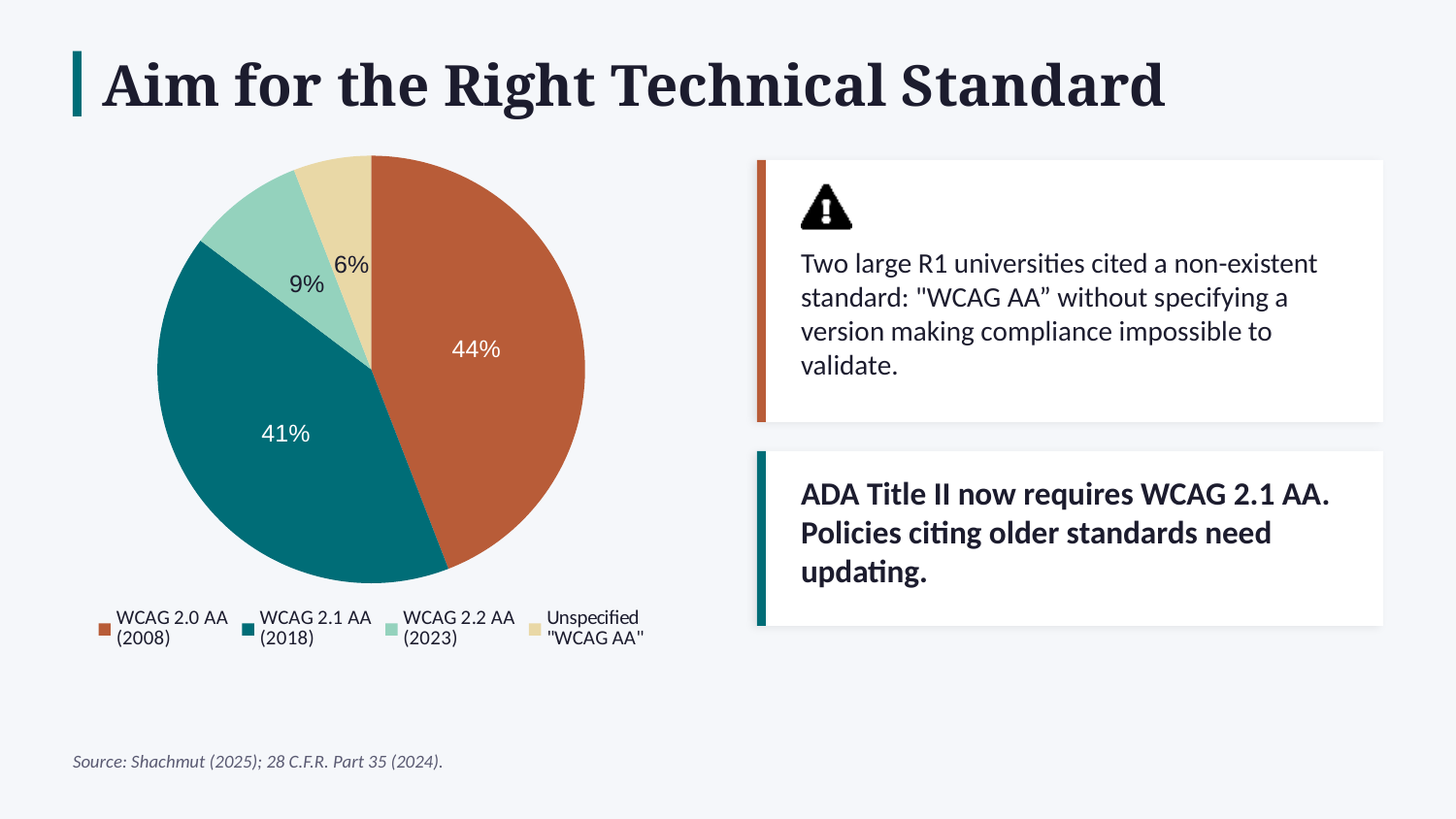
What is the combined share of WCAG 2.2 AA (2023) and Unspecified "WCAG AA"? 15% Which category has the smallest slice of the pie? Unspecified "WCAG AA" What share of the pie is WCAG 2.0 AA (2008)? 44% What kind of chart is shown on the slide? Pie chart Which is larger: the WCAG 2.2 AA (2023) slice or the Unspecified "WCAG AA" slice? WCAG 2.2 AA (2023) How many categories does the pie chart have? 4 What share of the pie is WCAG 2.1 AA (2018)? 41% What share of the pie is Unspecified "WCAG AA"? 6% What is the difference between the WCAG 2.0 AA (2008) share and the WCAG 2.1 AA (2018) share? 3% What colour is the WCAG 2.1 AA (2018) slice? Teal Which category has the largest slice of the pie? WCAG 2.0 AA (2008) What share of the pie is WCAG 2.2 AA (2023)? 9%